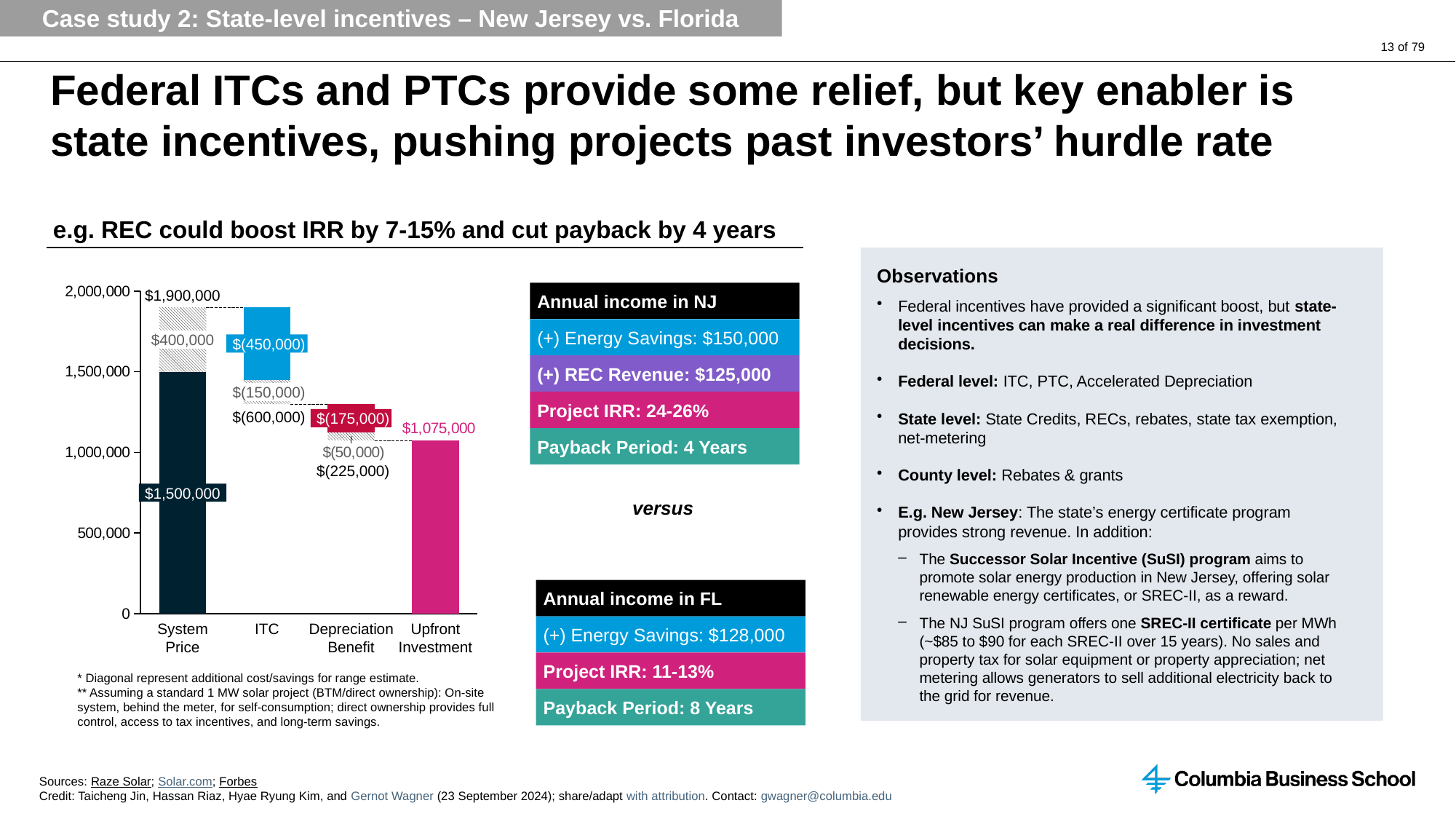
What is the difference between the System Price ($1,500,000) and the Upfront Investment ($1,075,000) in the chart? $425,000 What is the value labelled on the solid Depreciation Benefit bar in the chart? $(175,000) Which is larger in the chart: the System Price bar or the Upfront Investment bar? System Price What value is shown for Upfront Investment in the chart? $1,075,000 What is the combined ITC reduction shown below the ITC bar in the chart? $(600,000) What is the value labelled on the ITC bar (solid blue portion) in the chart? $(450,000) Is the Upfront Investment bar greater or less than 1,000,000 on the y axis? greater What is the data label on the System Price bar in the waterfall chart? $1,500,000 How many categories are shown on the x axis of the chart? 4 What is the combined Depreciation Benefit reduction shown below the Depreciation Benefit bar? $(225,000) What is the label at the top of the System Price column, above the diagonal range section? $1,900,000 What is the maximum value shown on the y axis of the chart? 2,000,000